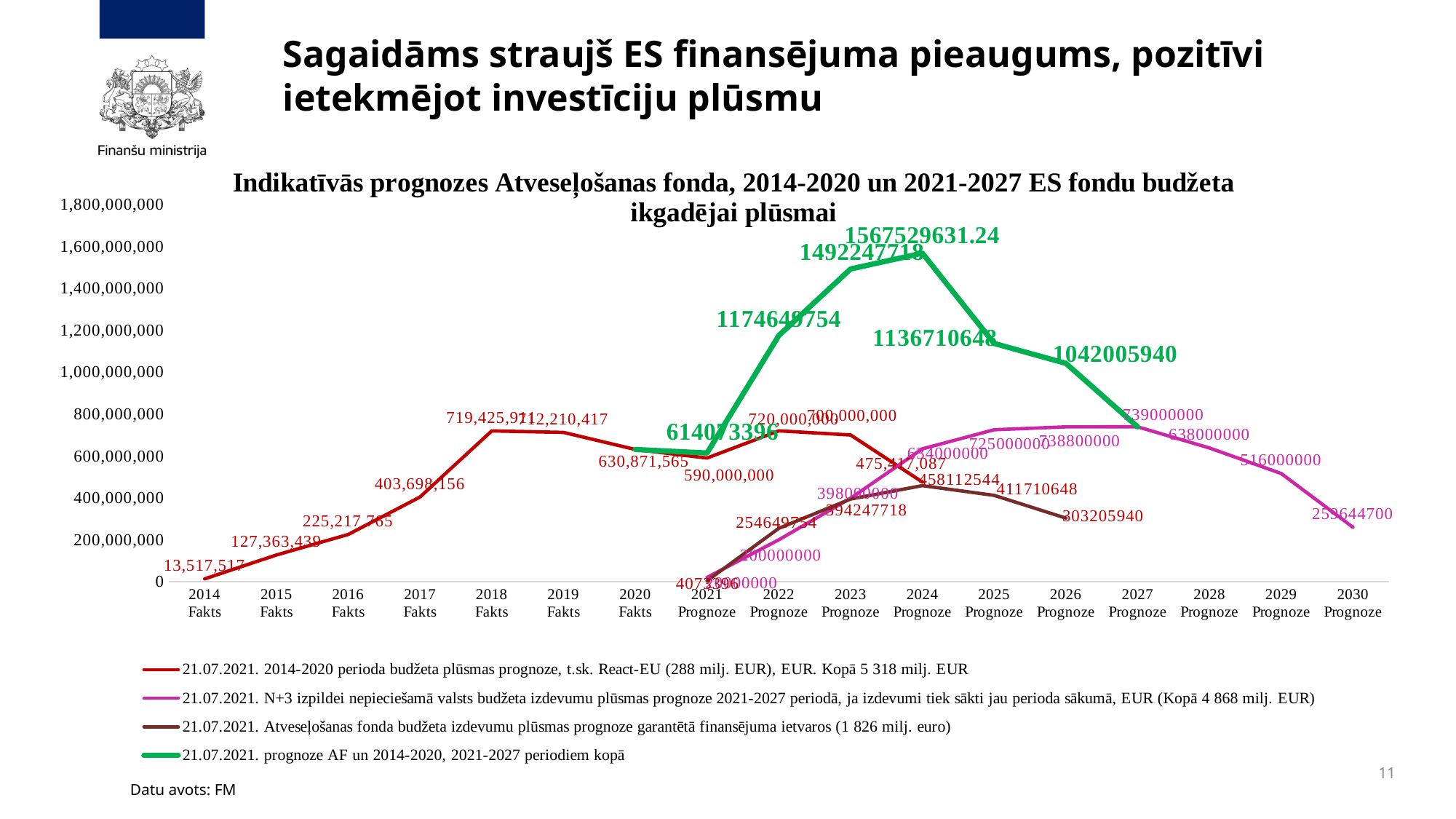
What is the value of the red 2014-2020 period series for 2014 Fakts? 13,517,517 What is the value of the red 2014-2020 period series for 2018 Fakts? 719,425,911 What is the value of the brown Atveseļošanas fonda series for 2026 Prognoze? 303205940 What kind of chart is shown on the slide? line chart What is the value of the magenta N+3 series for 2030 Prognoze? 259644700 Is the value of the green combined series for 2023 Prognoze greater or less than 1,400,000,000? greater How many years are shown along the x axis? 17 In which year does the green combined series (prognoze AF un 2014-2020, 2021-2027 periodiem kopā) reach its highest value? 2024 Prognoze How many series does the legend list? 4 Which is larger for the red 2014-2020 period series: the value for 2018 Fakts or 2019 Fakts? 2018 Fakts What is the difference between the magenta N+3 series values for 2027 Prognoze and 2028 Prognoze? 101000000 What is the highest value of the green combined series? 1567529631.24